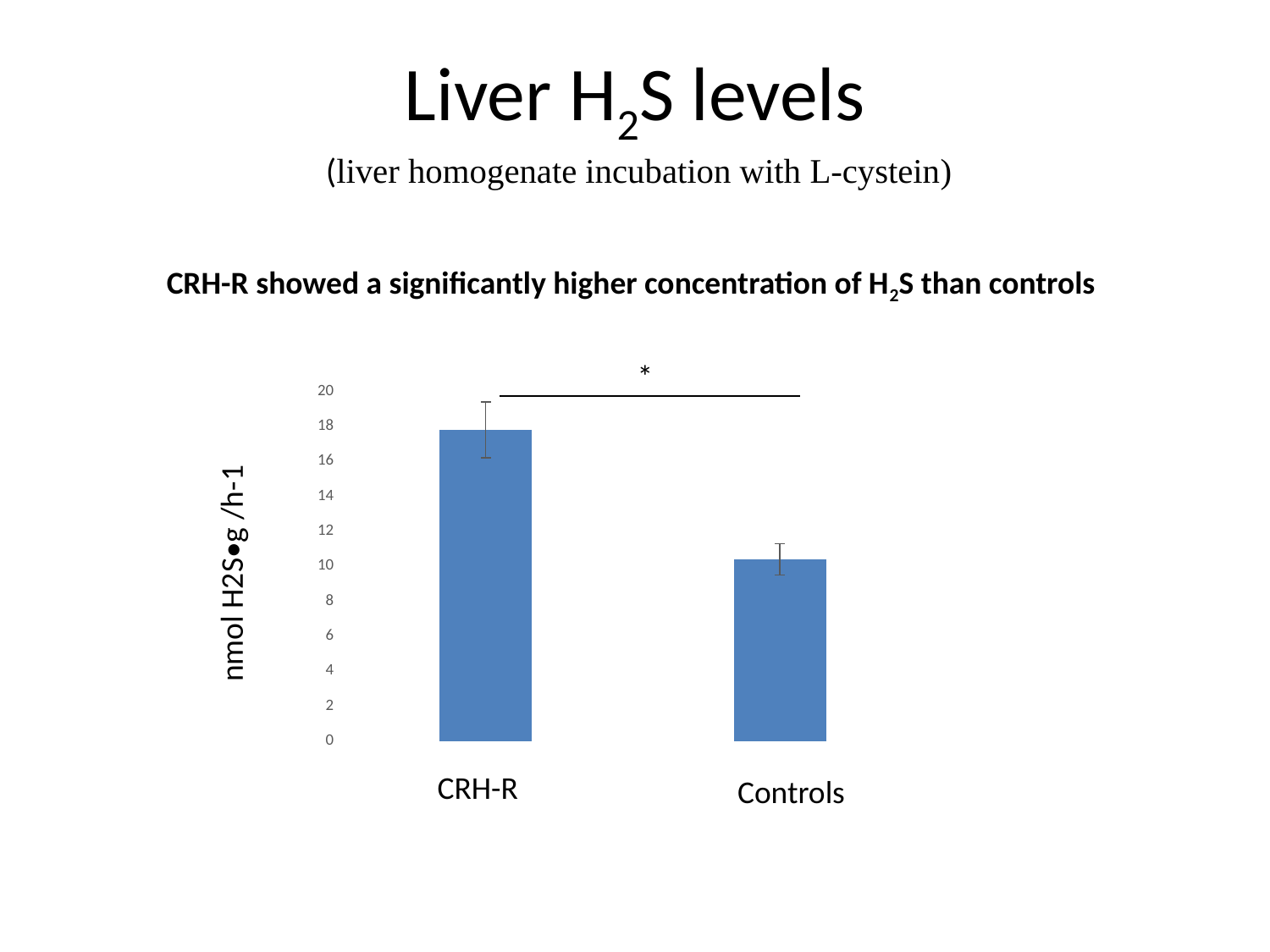
How many categories are plotted on the x axis of the chart? 2 Is the value for CRH-R greater or less than 16? greater Which category has the highest value in the chart? CRH-R Which is larger, the value for CRH-R or the value for Controls? CRH-R Which category has the lowest value in the chart? Controls What kind of chart is shown on the slide? bar chart Is the value for Controls greater or less than 12? less Is the value for Controls greater or less than 8? greater What is the label on the y axis of the chart? nmol H2S●g /h-1 What is the highest tick value shown on the y axis of the chart? 20